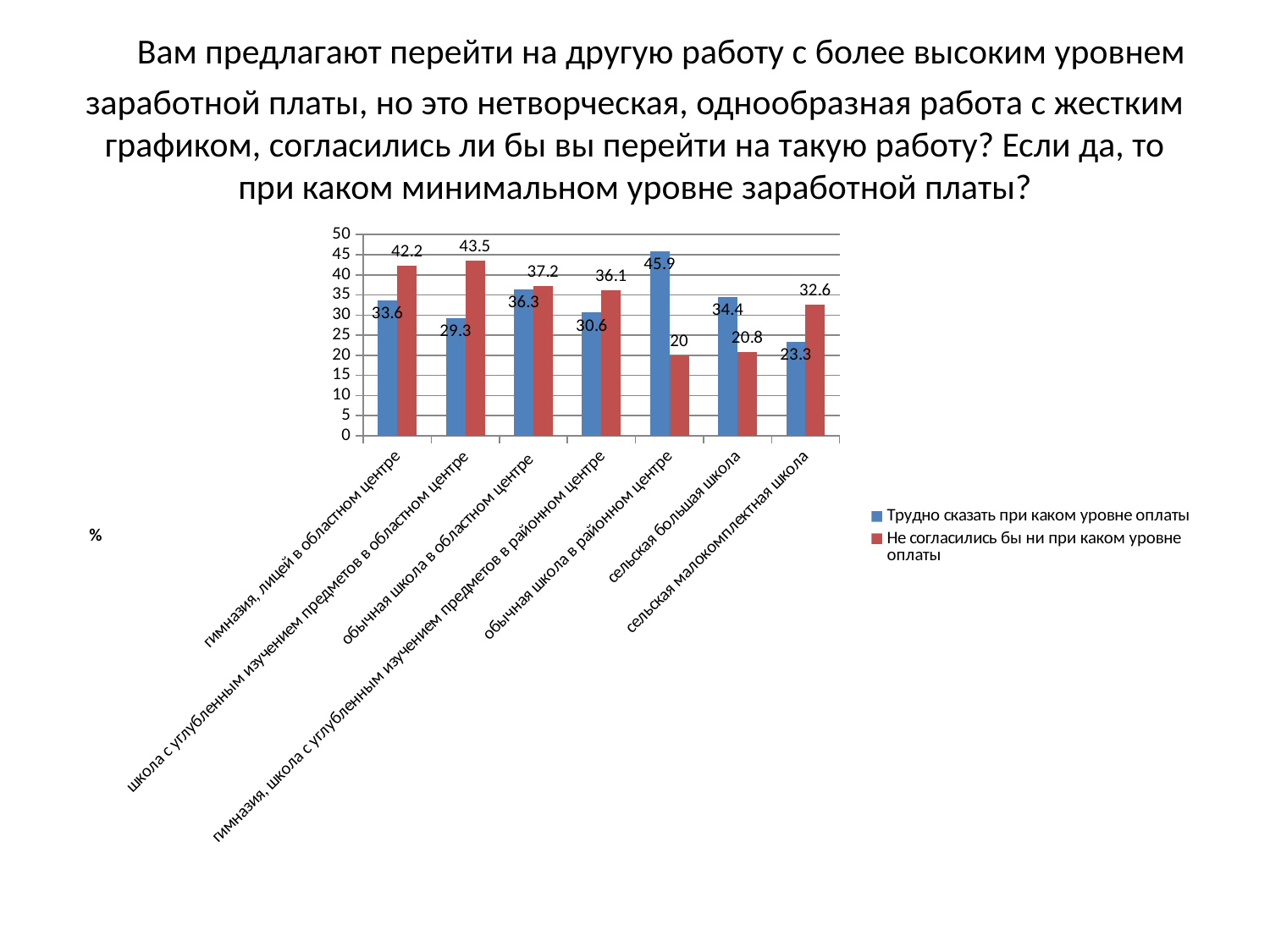
How many categories are shown on the x axis of the chart? 7 How many series does the chart's legend list? 2 What is the difference between the two series' values for "обычная школа в районном центре"? 25.9 For "гимназия, лицей в областном центре", which series has the larger value? Не согласились бы ни при каком уровне оплаты For "сельская большая школа", which series has the larger value? Трудно сказать при каком уровне оплаты Which category has the lowest value in the series "Трудно сказать при каком уровне оплаты"? сельская малокомплектная школа What value does the series "Трудно сказать при каком уровне оплаты" show for "обычная школа в районном центре"? 45.9 What value does the series "Не согласились бы ни при каком уровне оплаты" show for "сельская малокомплектная школа"? 32.6 Which category has the lowest value in the series "Не согласились бы ни при каком уровне оплаты"? обычная школа в районном центре Which category has the highest value in the series "Трудно сказать при каком уровне оплаты"? обычная школа в районном центре What value does the series "Не согласились бы ни при каком уровне оплаты" show for "школа с углубленным изучением предметов в областном центре"? 43.5 What kind of chart is shown on the slide? bar chart